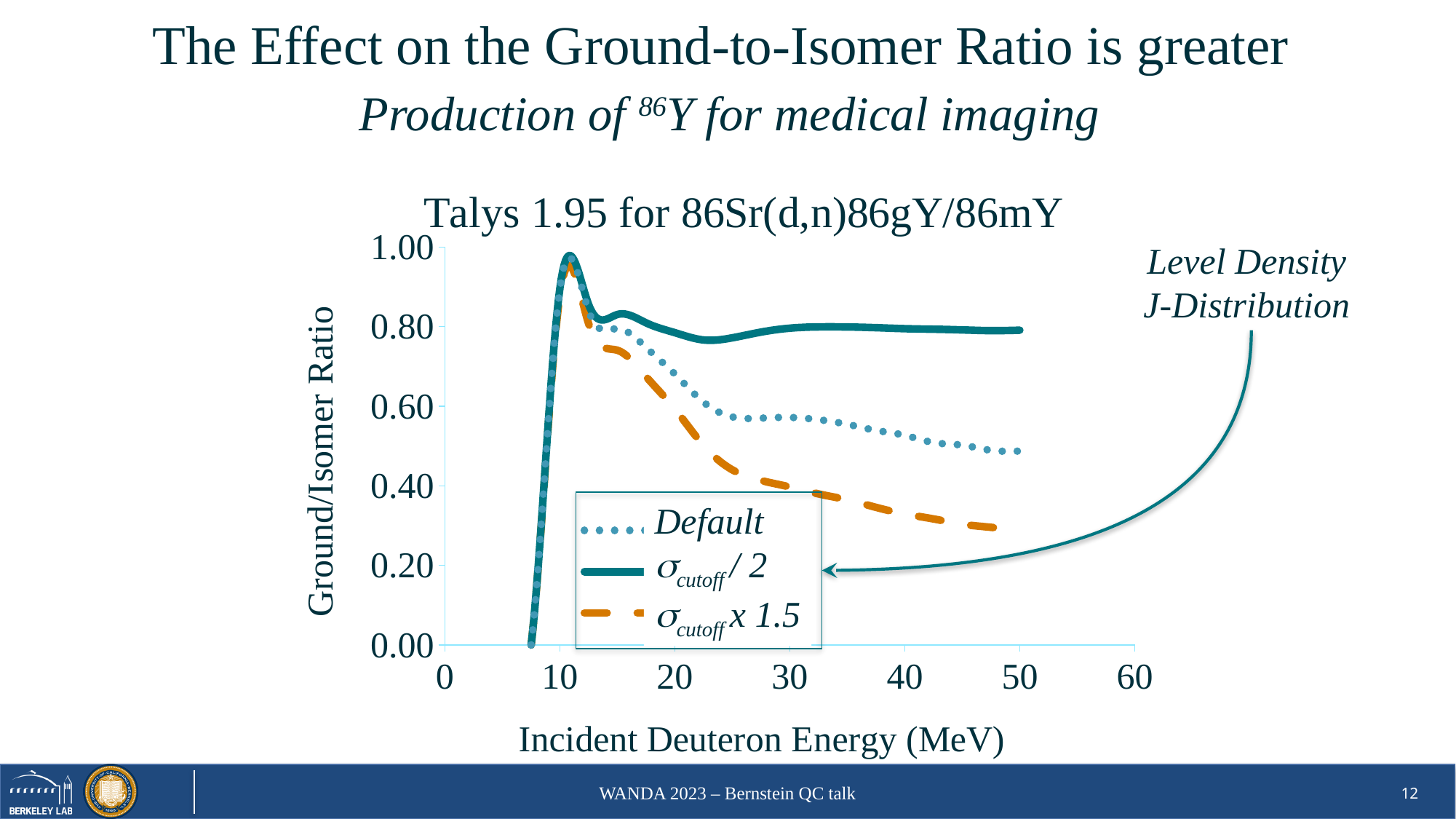
Which series has the lowest value at 40 MeV? σcutoff x 1.5 Is the value of the σcutoff x 1.5 series at 40 MeV greater or less than 0.40? less Which series has the highest value at 50 MeV? σcutoff / 2 What is the title of the chart? Talys 1.95 for 86Sr(d,n)86gY/86mY What kind of chart is shown on the slide? line chart Is the value of the σcutoff / 2 series at 50 MeV greater or less than 0.60? greater How many series does the chart legend list? 3 Is the value of the Default series at 50 MeV greater or less than 0.60? less What is the label of the x axis of the chart? Incident Deuteron Energy (MeV) Does the σcutoff x 1.5 series rise or fall between 20 MeV and 50 MeV? fall At 40 MeV, which series has the higher value, σcutoff / 2 or Default? σcutoff / 2